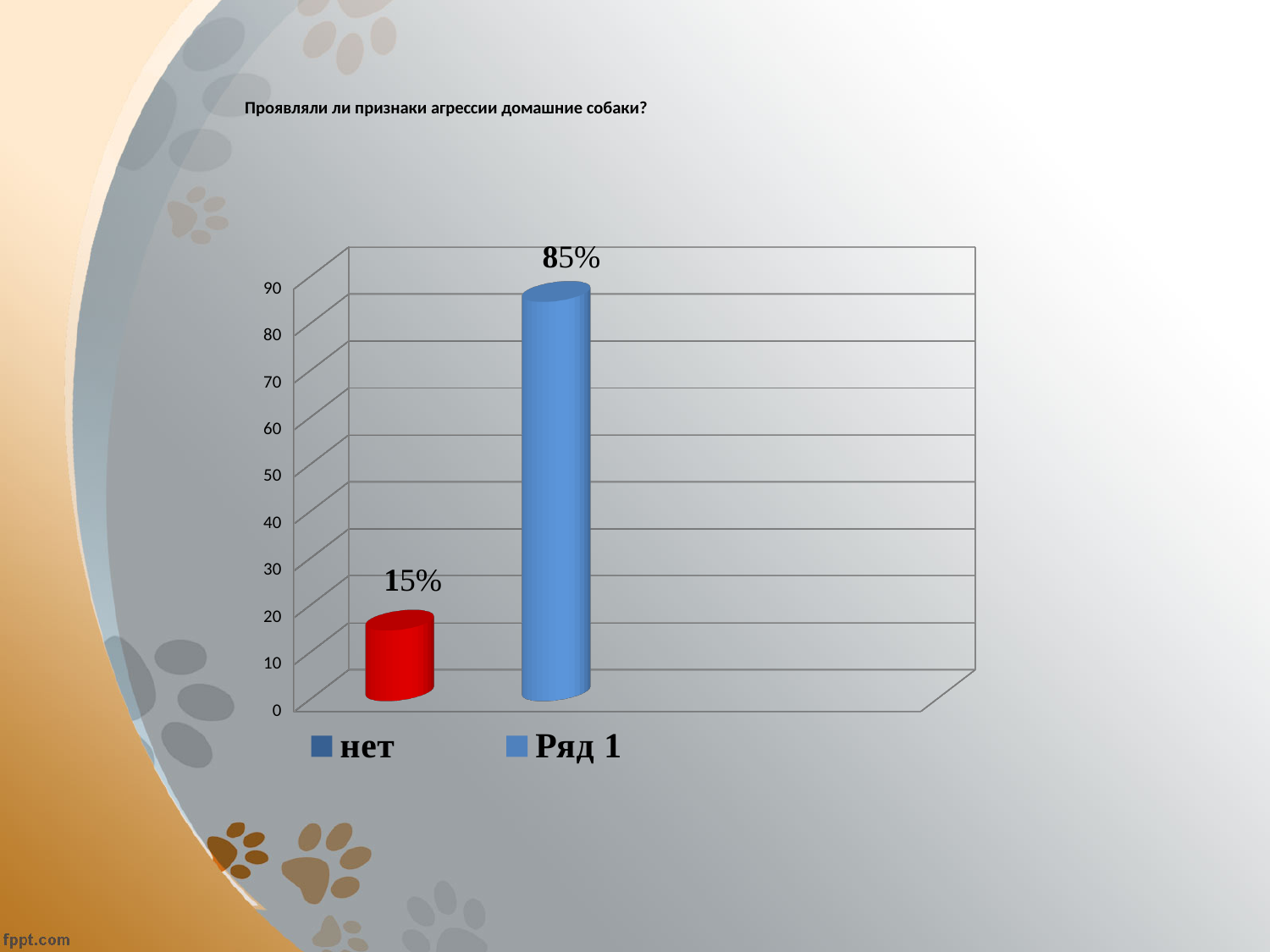
What value is printed above the blue bar? 85% What is the difference between the blue bar's value and the red bar's value? 70% Which bar shows the lowest value? the red bar, 15% How many entries does the legend list? 2 Is the value of the blue bar greater or less than 50? greater What are the two entries listed in the legend? нет and Ряд 1 How many bars are plotted in the chart? 2 What kind of chart is shown on the slide? bar chart Which is larger, the value of the red bar or the value of the blue bar? the blue bar Which bar shows the highest value? the blue bar (Ряд 1), 85% What value is printed above the red bar? 15% Is the value of the red bar greater or less than 20? less